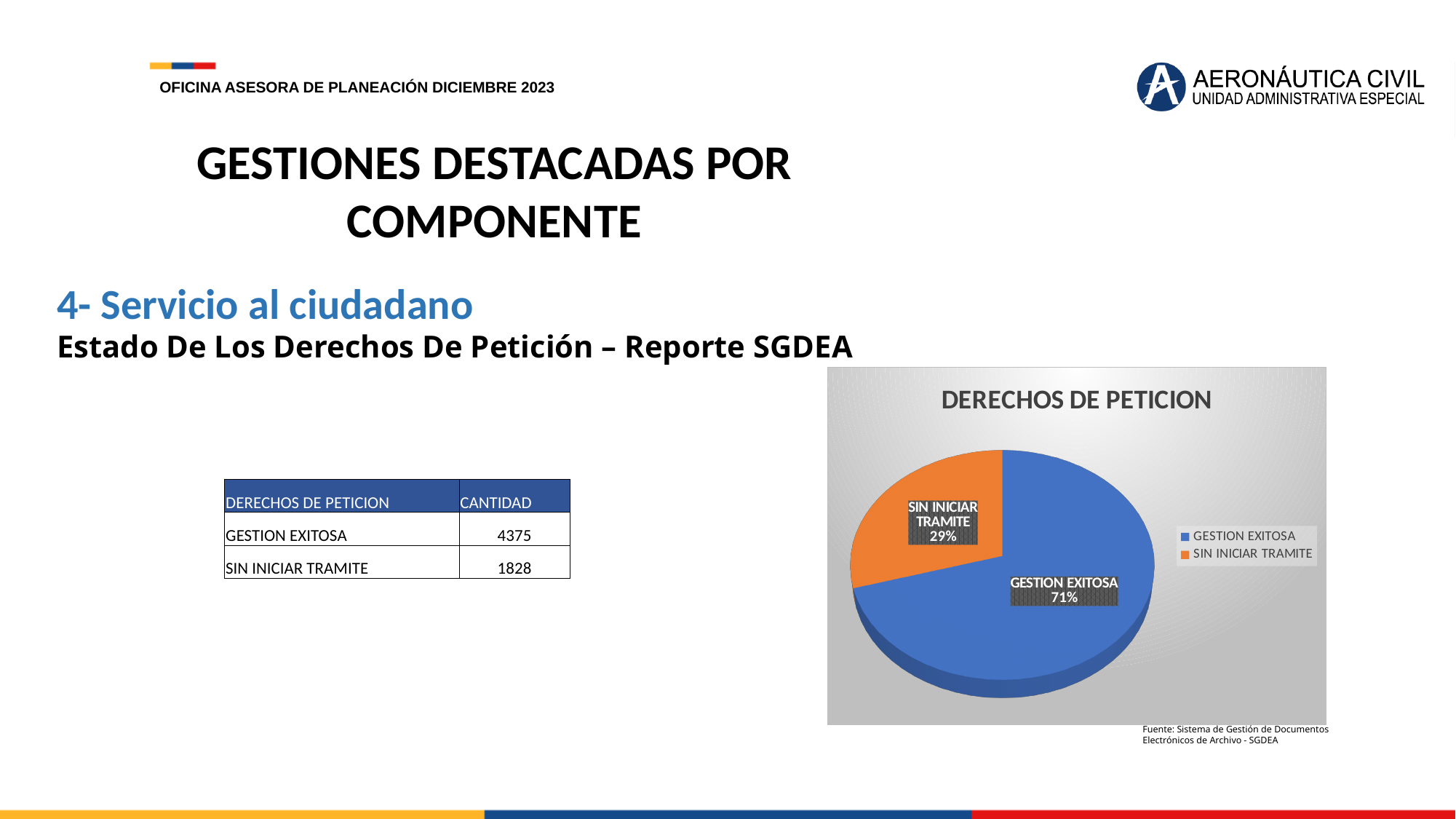
Which slice of the pie is the largest? GESTION EXITOSA How many entries does the legend list? 2 What colour is the SIN INICIAR TRAMITE slice? orange What share of the pie does SIN INICIAR TRAMITE represent? 29% What is the title of the chart? DERECHOS DE PETICION Which is larger, the GESTION EXITOSA slice or the SIN INICIAR TRAMITE slice? GESTION EXITOSA What is the difference in percentage points between the GESTION EXITOSA and SIN INICIAR TRAMITE slices? 42 How many slices does the pie chart have? 2 What share of the pie does GESTION EXITOSA represent? 71% What type of chart is shown on the slide? pie chart Which slice of the pie is the smallest? SIN INICIAR TRAMITE